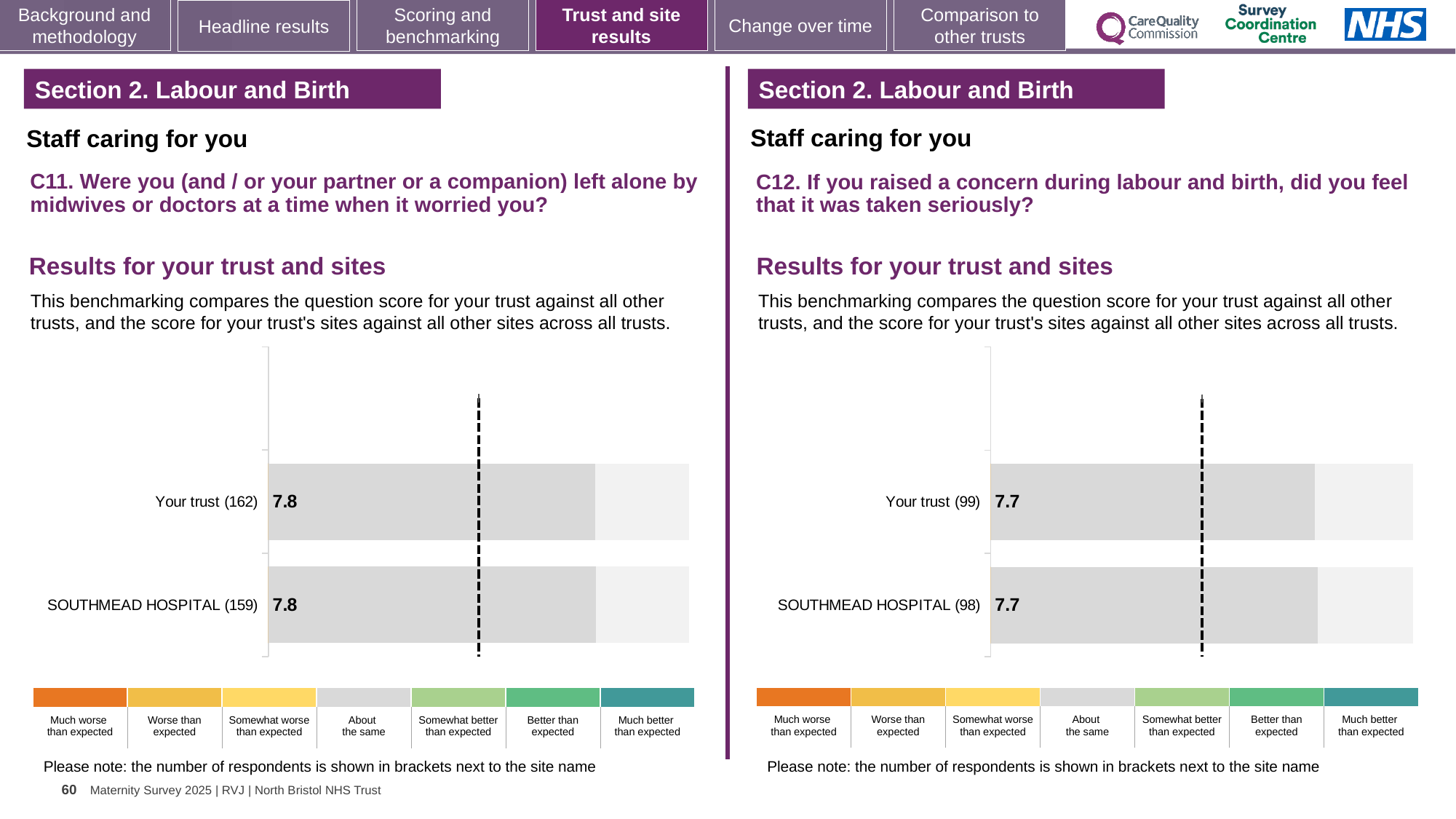
On the C12 chart (right), how many respondents are shown in brackets for SOUTHMEAD HOSPITAL? 98 On the C11 chart (left), what is the score for SOUTHMEAD HOSPITAL? 7.8 How many bars are plotted on the C11 chart (left)? 2 On the C12 chart (right), what is the difference between the score for Your trust and the score for SOUTHMEAD HOSPITAL? 0.0 How many bars are plotted on the C12 chart (right)? 2 On the C12 chart (right), what is the score for SOUTHMEAD HOSPITAL? 7.7 On the C11 chart (left), what is the score for Your trust? 7.8 How many benchmark categories are shown in the colour key below the C11 chart (left)? 7 On the C12 chart (right), what is the score for Your trust? 7.7 What kind of chart is used on the C12 chart (right)? Bar chart On the C11 chart (left), how many respondents are shown in brackets for Your trust? 162 On the C11 chart (left), what is the difference between the score for Your trust and the score for SOUTHMEAD HOSPITAL? 0.0